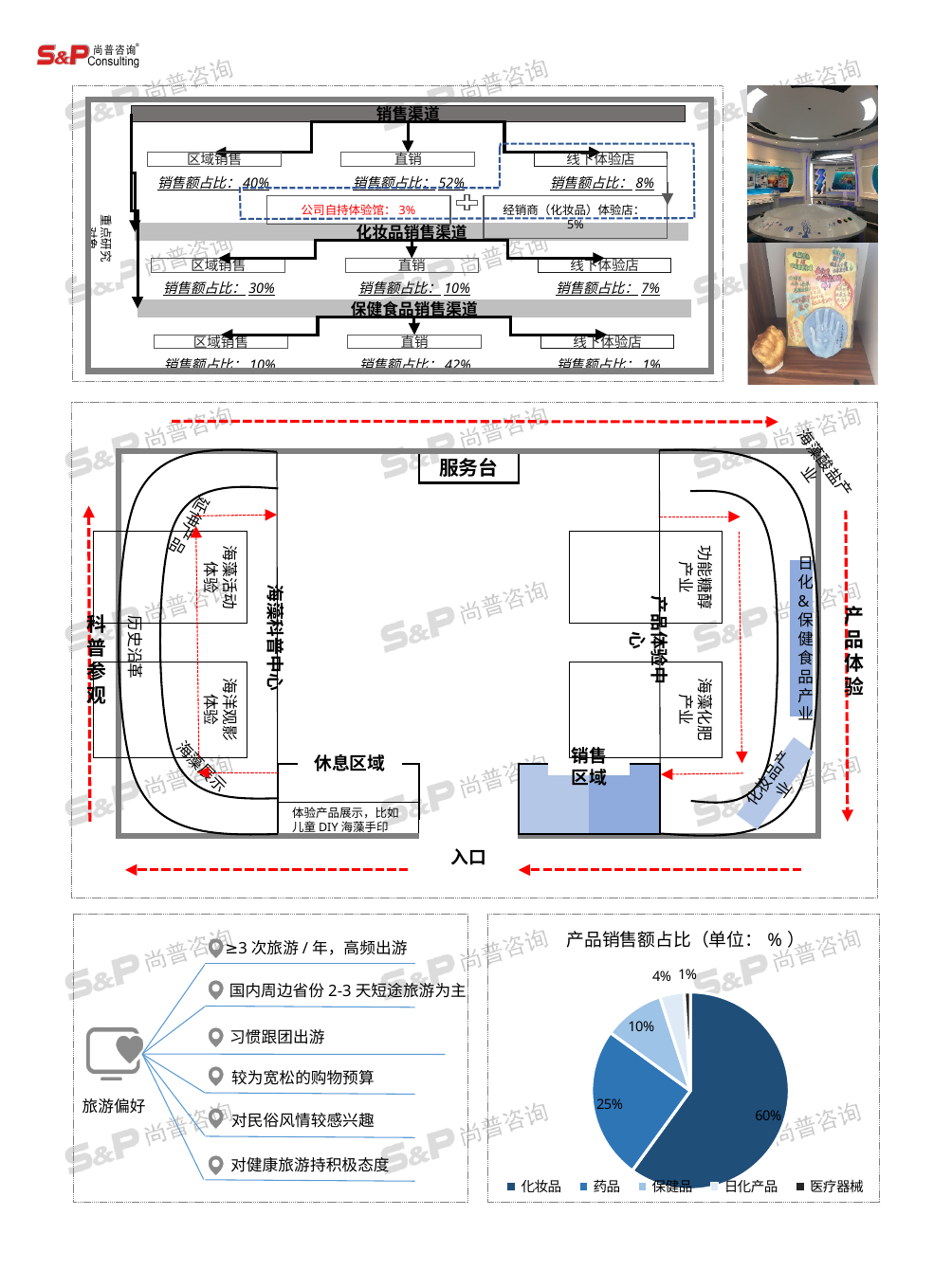
In the 产品销售额占比 pie chart, which is larger, the share of 保健品 or the share of 日化产品? 保健品 How many categories does the legend of the 产品销售额占比 pie chart list? 5 In the 产品销售额占比 pie chart, which category has the smallest share? 医疗器械 In the 产品销售额占比 pie chart, what is the share for 药品? 25% What kind of chart is the 产品销售额占比 chart? pie chart In the 产品销售额占比 pie chart, what is the share for 医疗器械? 1% In the 产品销售额占比 pie chart, what is the share for 保健品? 10% In the 产品销售额占比 pie chart, what is the share for 化妆品? 60% In the 产品销售额占比 pie chart, what is the difference between the shares of 化妆品 and 药品? 35% What is the title of the pie chart on the slide? 产品销售额占比（单位：%） In the 产品销售额占比 pie chart, what is the share for 日化产品? 4% In the 产品销售额占比 pie chart, which category has the largest share? 化妆品